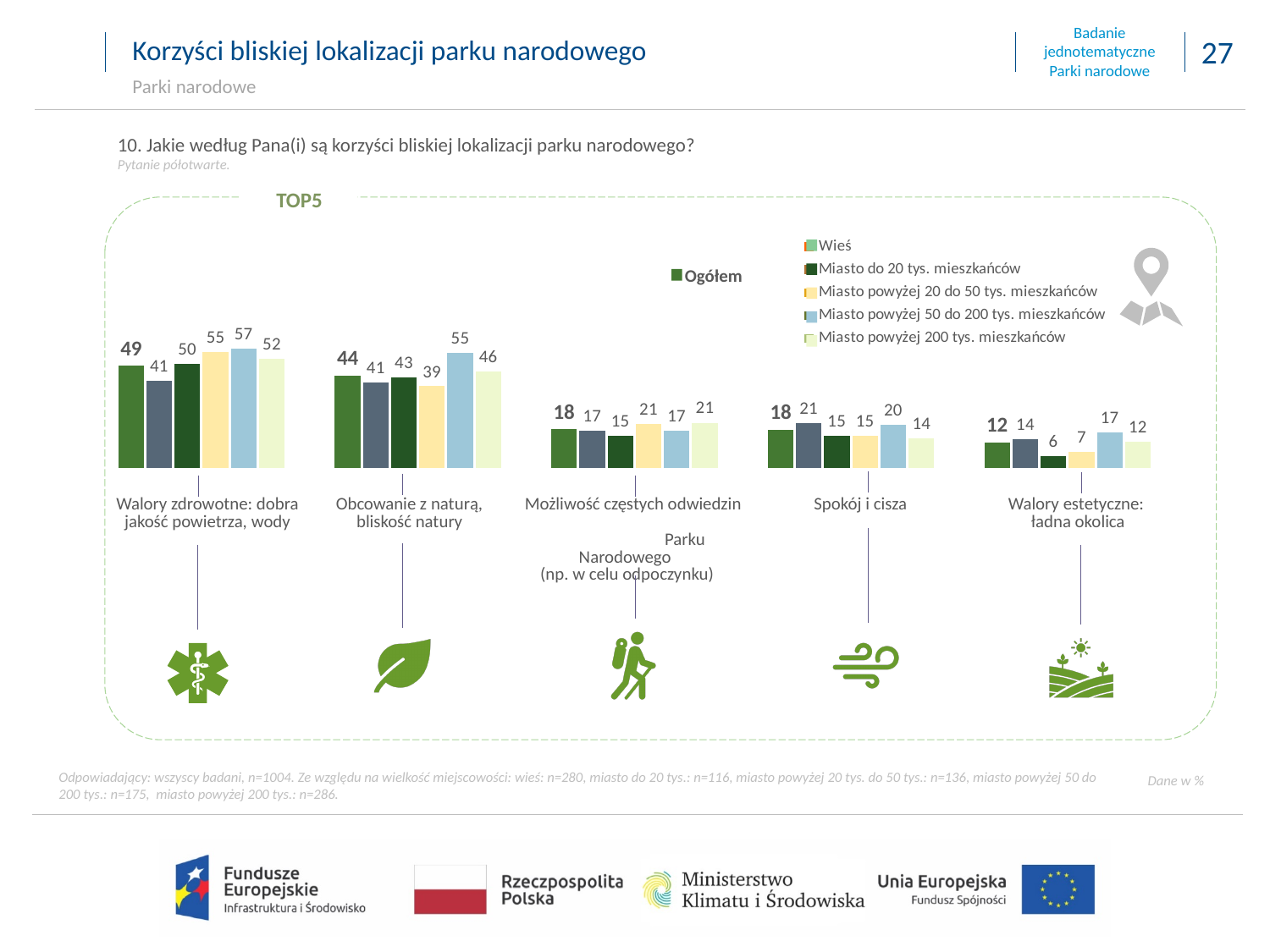
What kind of chart is shown on the slide? Bar chart What is the Ogółem value for "Walory zdrowotne: dobra jakość powietrza, wody"? 49 What is the value for Wieś in the "Obcowanie z naturą, bliskość natury" category? 41 Which category has the highest Ogółem value? Walory zdrowotne: dobra jakość powietrza, wody How many categories (benefits) are shown in the chart? 5 What is the difference between the Miasto powyżej 50 do 200 tys. mieszkańców value and the Wieś value for "Walory zdrowotne: dobra jakość powietrza, wody"? 16 What is the value for Miasto powyżej 50 do 200 tys. mieszkańców in the "Walory estetyczne: ładna okolica" category? 17 How many series does the legend list? 6 Which category has the lowest Ogółem value? Walory estetyczne: ładna okolica Which series has the lowest value in the "Walory estetyczne: ładna okolica" category? Miasto do 20 tys. mieszkańców In the "Spokój i cisza" category, which is larger: the value for Wieś or the value for Miasto powyżej 200 tys. mieszkańców? Wieś What is the difference between the Ogółem values for "Obcowanie z naturą, bliskość natury" and "Możliwość częstych odwiedzin Parku Narodowego"? 26